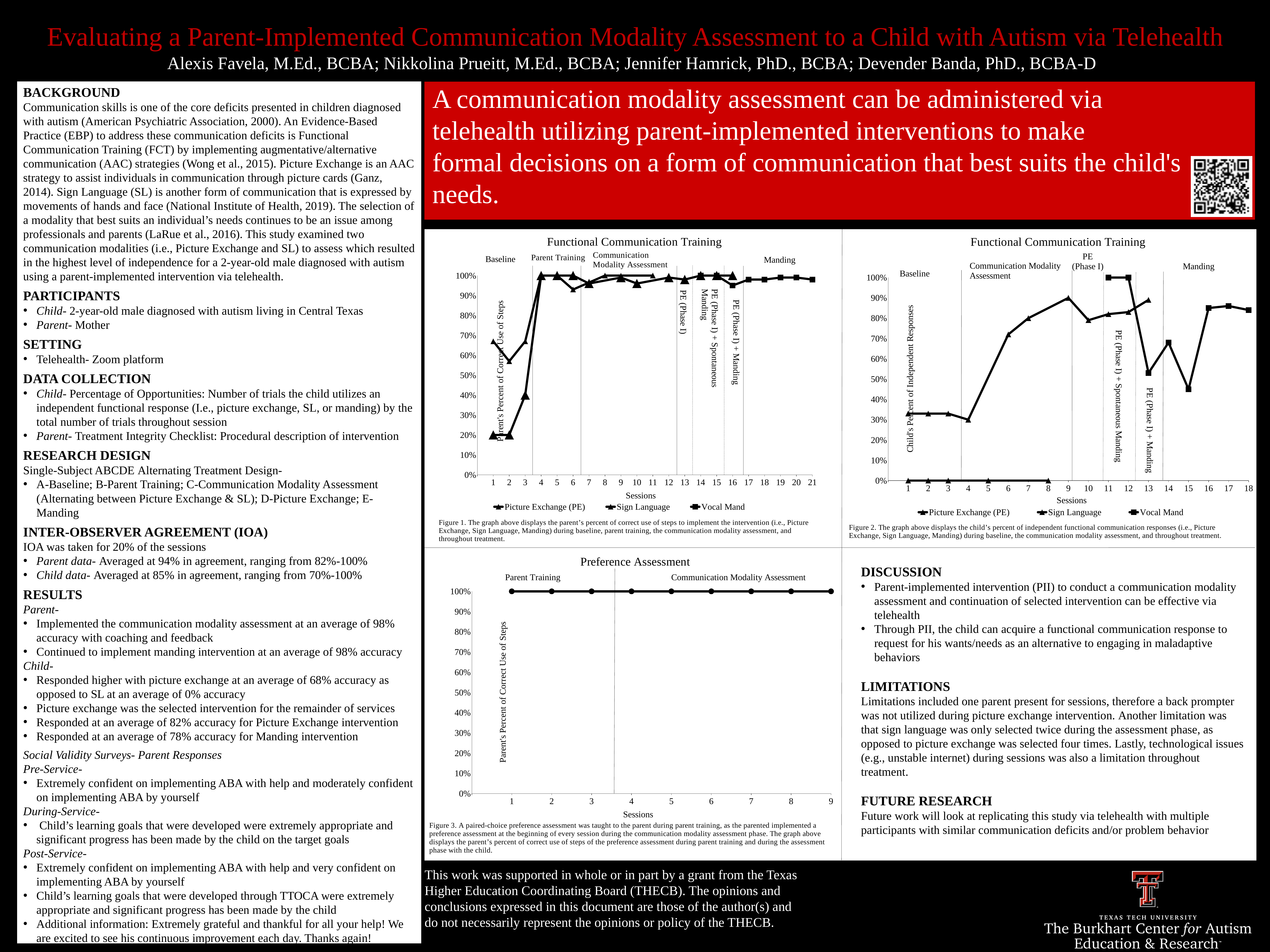
In the top-right 'Functional Communication Training' chart, what is the Sign Language value at session 5? 0% In the top-left 'Functional Communication Training' chart, how many sessions are shown on the x axis? 21 What kind of chart is the top-left chart titled 'Functional Communication Training'? line chart In the top-right 'Functional Communication Training' chart, is the Vocal Mand value at session 15 greater or less than 50%? less In the bottom 'Preference Assessment' chart, do the values rise, fall, or stay flat across the sessions? stay flat In the top-left 'Functional Communication Training' chart, is the Picture Exchange (PE) value at session 1 greater or less than 50%? less In the top-left 'Functional Communication Training' chart, is the Sign Language value at session 3 greater or less than 50%? greater How many series does the legend of the top-left 'Functional Communication Training' chart list? 3 In the top-right 'Functional Communication Training' chart, which series is lower at session 7, Picture Exchange (PE) or Sign Language? Sign Language In the top-right 'Functional Communication Training' chart, how many sessions are shown on the x axis? 18 In the bottom 'Preference Assessment' chart, what is the value at session 5? 100%